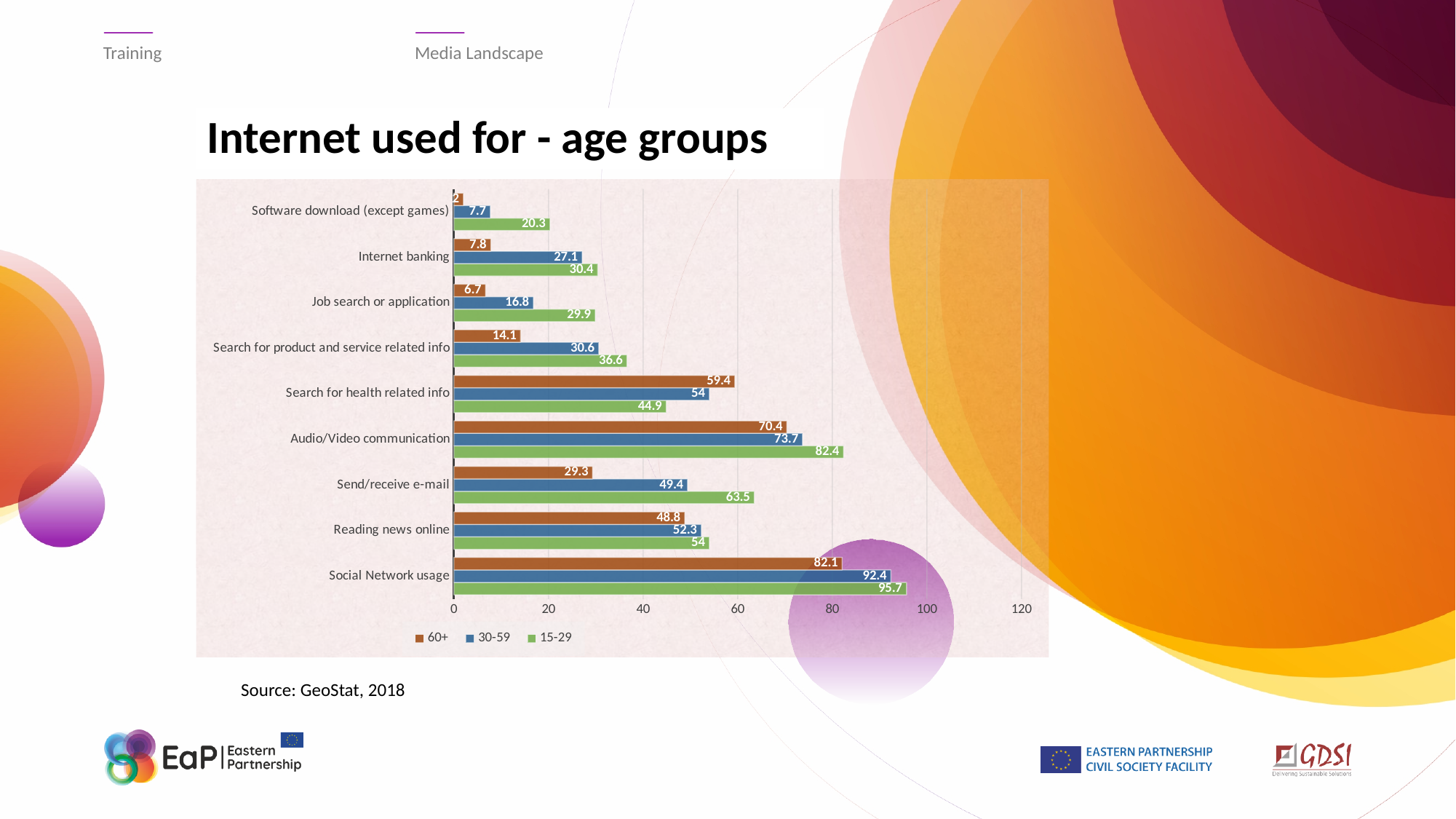
What is the value for the 60+ age group for Send/receive e-mail? 29.3 Which category has the lowest value for the 15-29 age group? Software download (except games) For Search for health related info, which age group has the larger value: 60+ or 15-29? 60+ What is the title of the chart? Internet used for - age groups What is the value for the 30-59 age group for Internet banking? 27.1 What is the difference between the 15-29 and 60+ values for Audio/Video communication? 12 Is the value for the 30-59 age group for Reading news online greater or less than 40? greater How many series does the legend list? 3 How many categories are shown on the chart? 9 What is the value for the 15-29 age group for Social Network usage? 95.7 What kind of chart is shown on the slide? Bar chart Which category has the highest value for the 60+ age group? Social Network usage